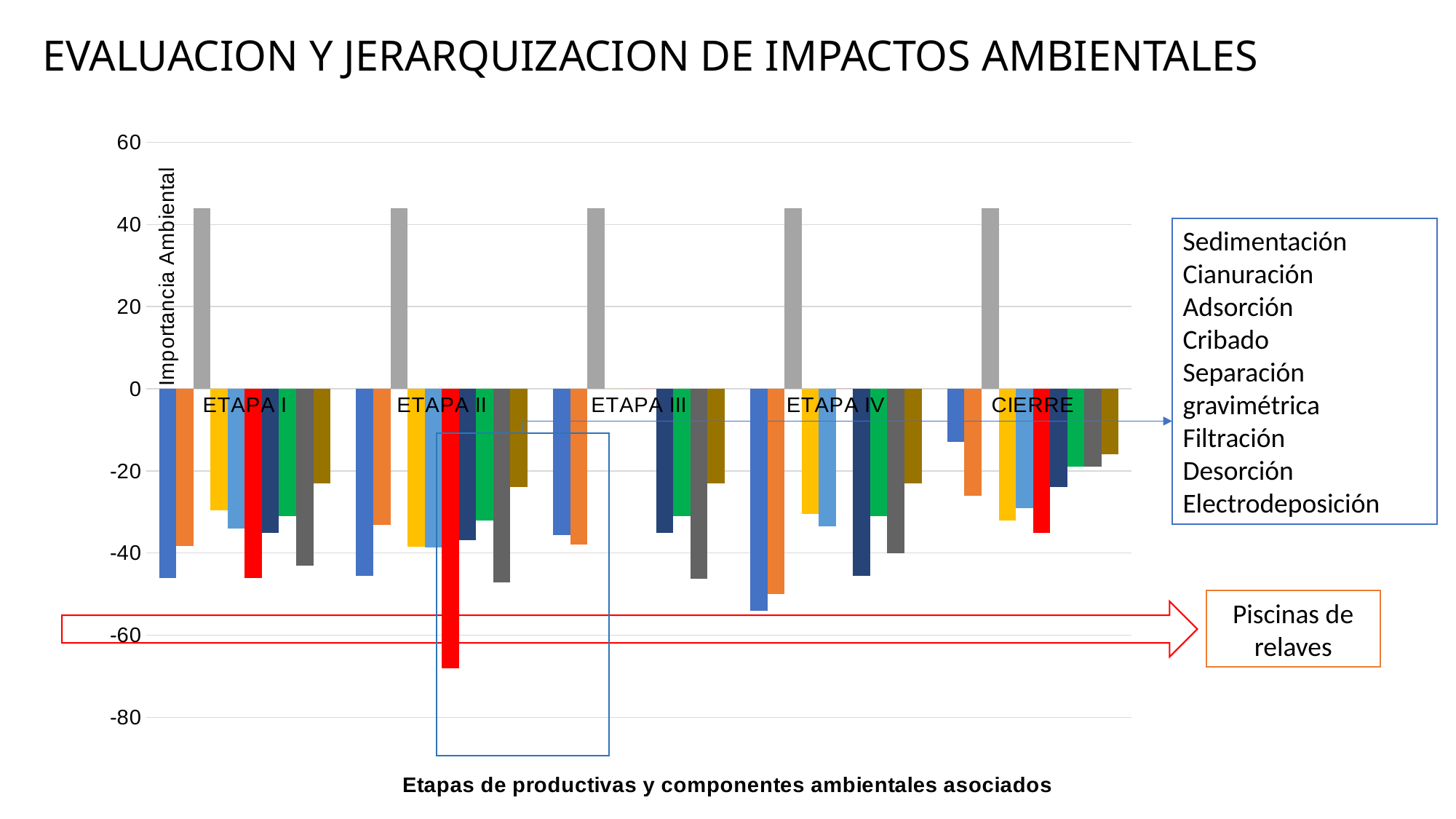
What is the label of the vertical axis of the chart? Importancia Ambiental How many categories (stages) are shown along the x axis of the chart? 5 Is the value of the red bar in ETAPA II greater or less than -60? less What kind of chart is shown on the slide? bar chart What is the title shown below the horizontal axis of the chart? Etapas de productivas y componentes ambientales asociados Is the value of the orange bar in CIERRE greater or less than -40? greater What is the lowest tick value shown on the vertical axis? -80 Is the value of the tall gray bar in ETAPA I greater or less than 40? greater Which category on the x axis contains the bar that reaches the lowest (most negative) value? ETAPA II Which has the more negative value: the red bar in ETAPA I or the red bar in ETAPA II? the red bar in ETAPA II